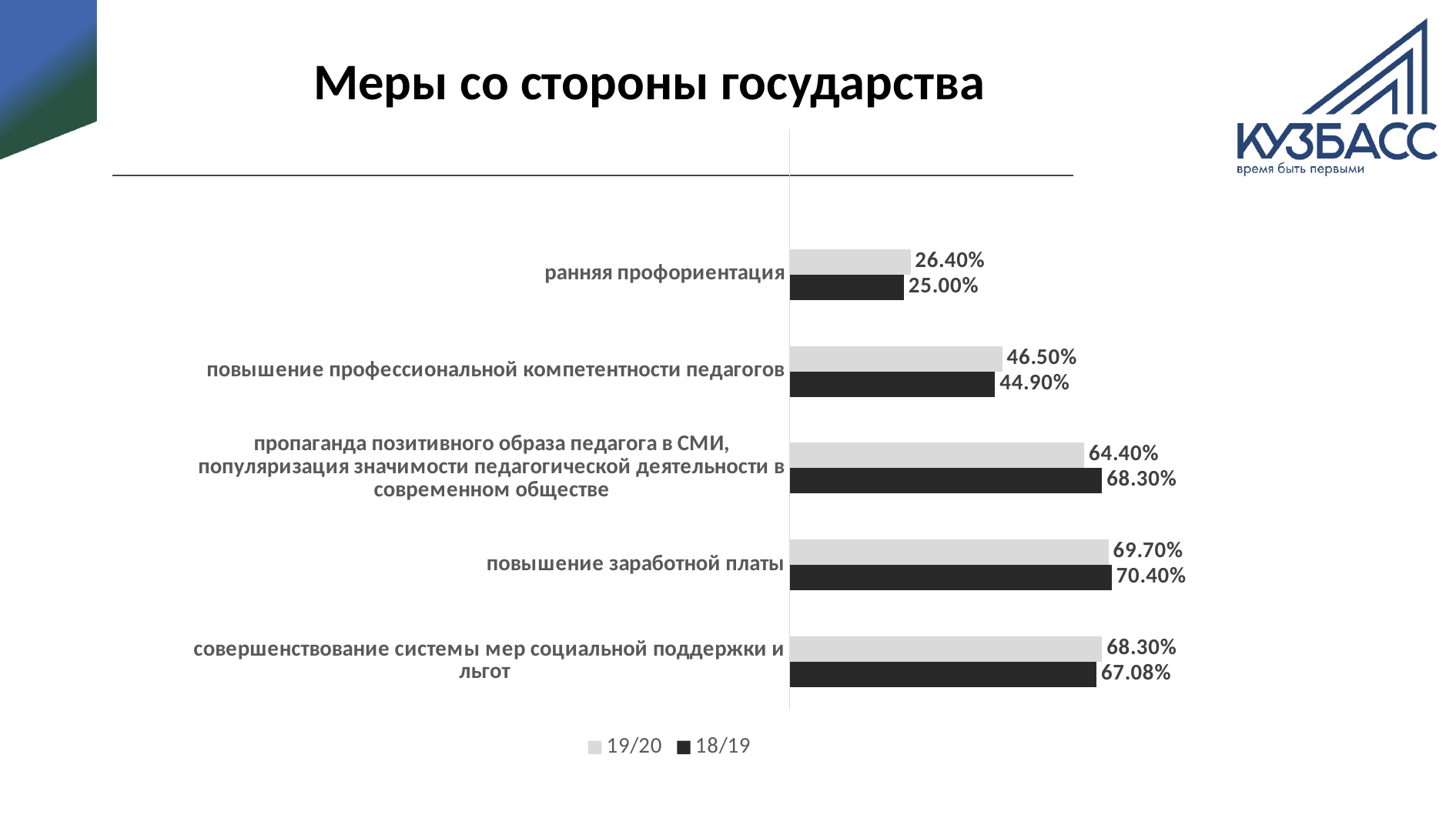
How many categories are shown in the chart? 5 What is the value for "повышение профессиональной компетентности педагогов" in the 19/20 series? 46.50% What is the difference between the 19/20 and 18/19 values for "повышение профессиональной компетентности педагогов"? 1.60% Which category has the lowest value in the 19/20 series? ранняя профориентация What is the title of the slide? Меры со стороны государства Which category has the highest value in the 18/19 series? повышение заработной платы What is the value for "совершенствование системы мер социальной поддержки и льгот" in the 18/19 series? 67.08% What is the value for "повышение заработной платы" in the 18/19 series? 70.40% For "пропаганда позитивного образа педагога в СМИ, популяризация значимости педагогической деятельности в современном обществе", which series has the larger value, 19/20 or 18/19? 18/19 What type of chart is shown on the slide? bar chart How many series does the legend list? 2 What is the value for "ранняя профориентация" in the 19/20 series? 26.40%